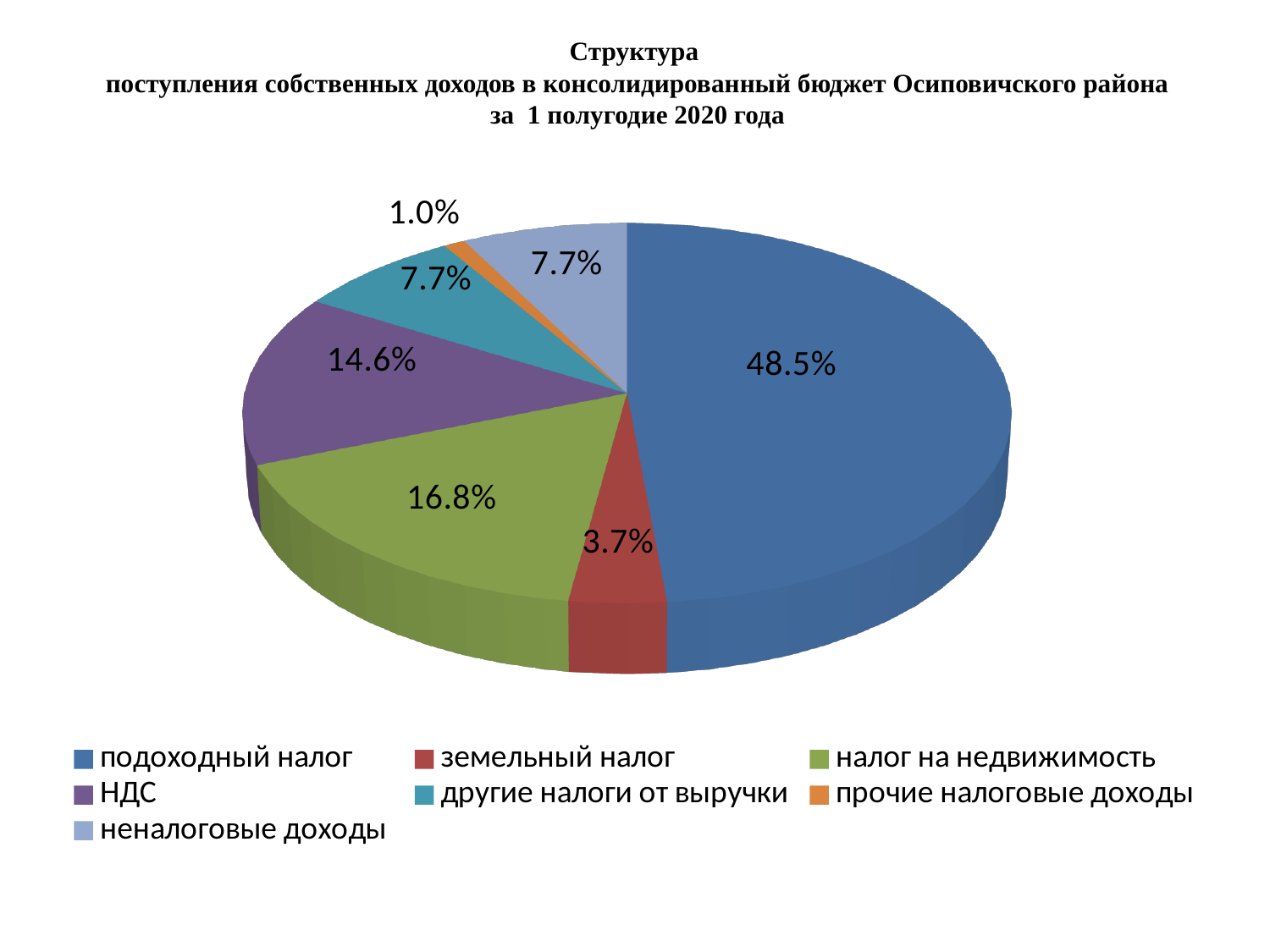
What is the value for прочие налоговые доходы? 1.0% What is the value for НДС? 14.6% What is the difference between the shares of налог на недвижимость and НДС? 2.2% Which category has the smallest share of the pie? прочие налоговые доходы What type of chart is shown on the slide? pie chart Which category has the largest share of the pie? подоходный налог What is the value for налог на недвижимость? 16.8% What share of the pie does подоходный налог have? 48.5% What is the value for земельный налог? 3.7% Which is larger, the share of НДС or the share of земельный налог? НДС How many categories does the pie chart have? 7 Which legend entry is shown in orange? прочие налоговые доходы